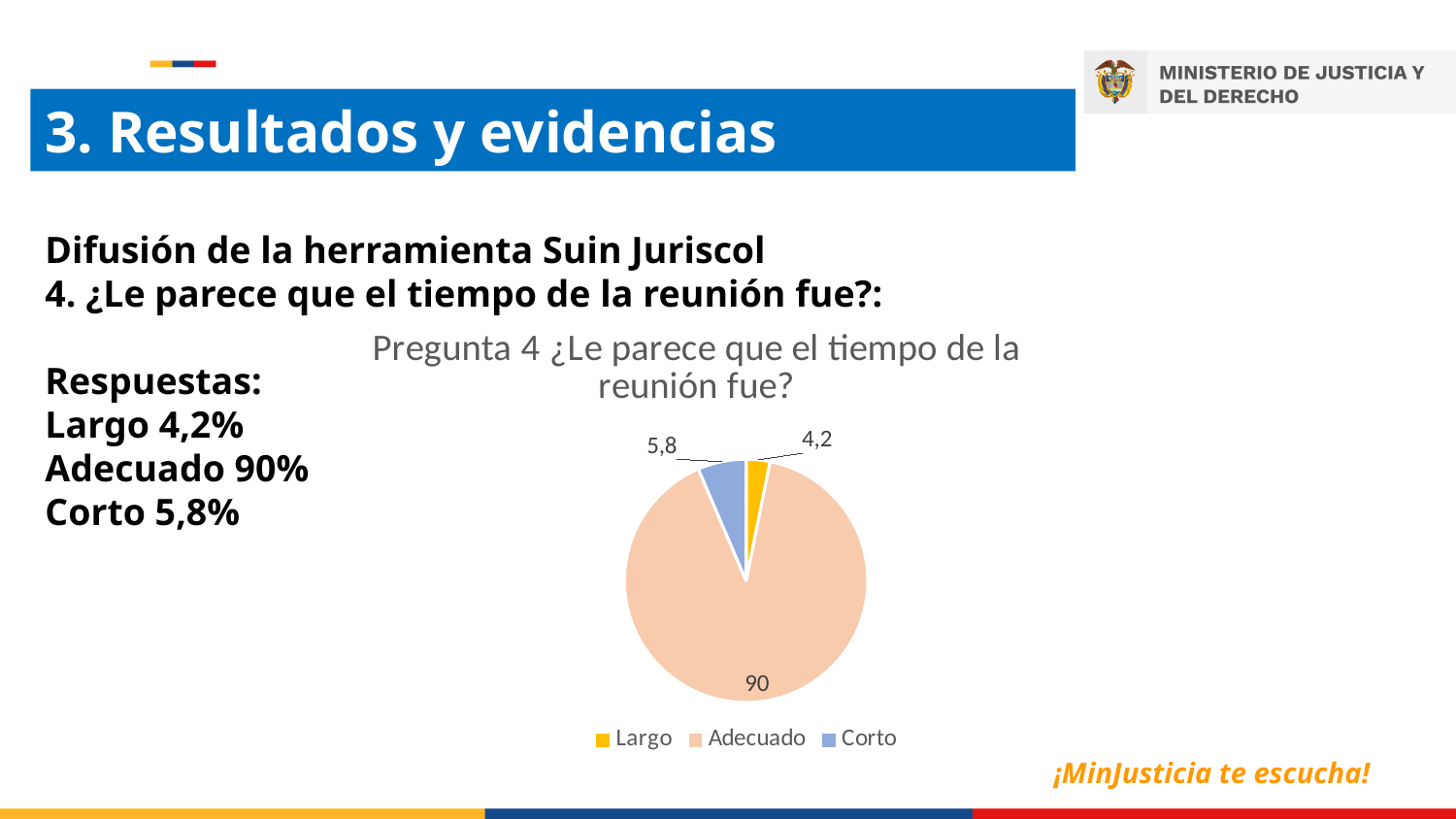
What is the difference between the values for Adecuado and Corto in the pie chart? 84,2 How many categories does the pie chart show? 3 Which is larger in the pie chart, Corto or Largo? Corto What is the difference between the values for Corto and Largo in the pie chart? 1,6 Which category has the largest slice in the pie chart? Adecuado What is the value shown for Largo in the pie chart? 4,2 What is the title of the pie chart? Pregunta 4 ¿Le parece que el tiempo de la reunión fue? What is the value shown for Adecuado in the pie chart? 90 What kind of chart is shown on the slide? pie chart What is the value shown for Corto in the pie chart? 5,8 Which category has the smallest slice in the pie chart? Largo Which colour represents Largo in the pie chart? yellow